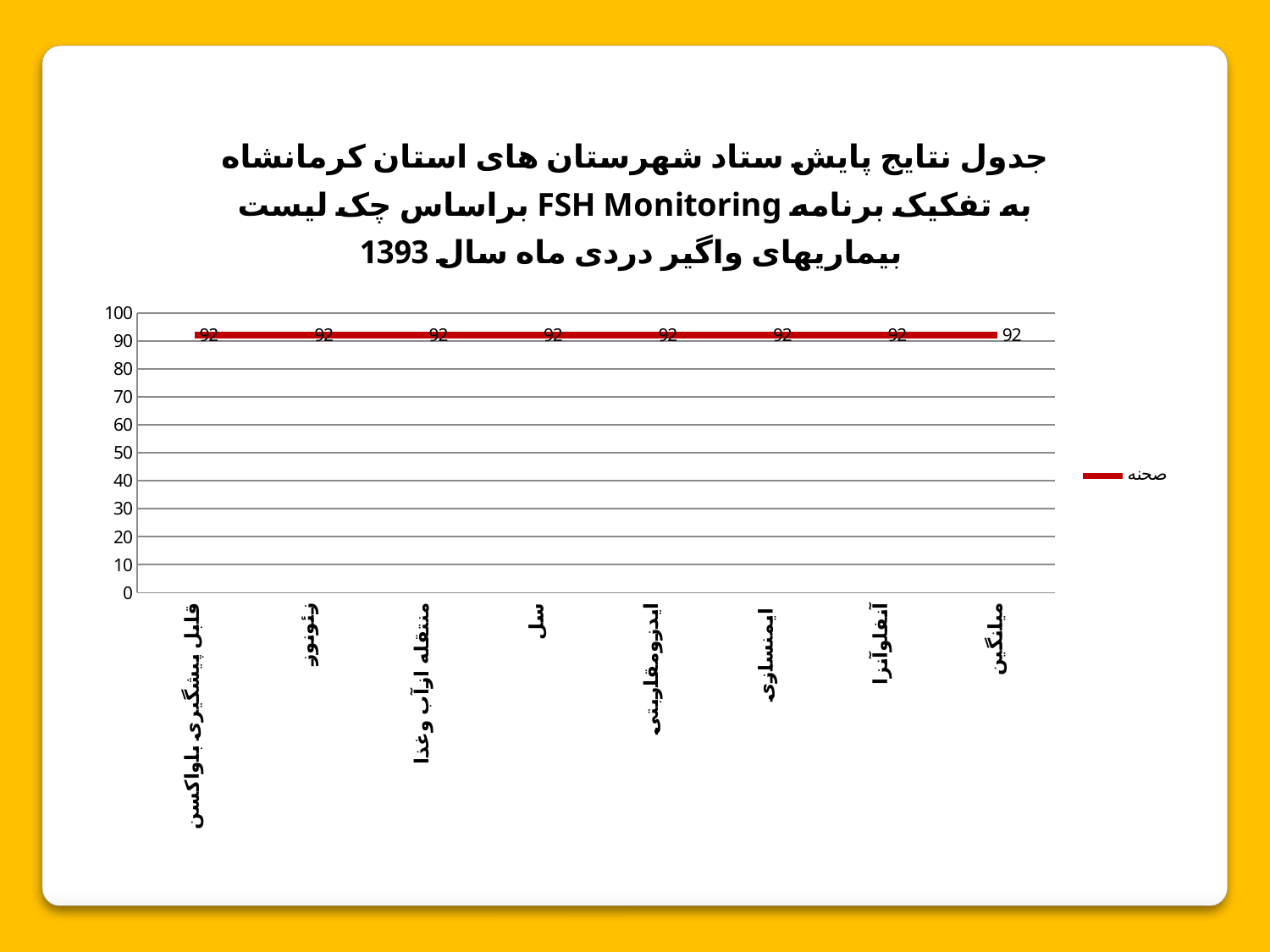
What is the name of the series shown in the legend? صحنه What is the difference between the values for ایمنسازی and سل? 0 What is the value for سل? 92 What colour is the line in the chart? red What is the value for زئونوز? 92 What kind of chart is shown on the slide? line chart How many categories are shown on the x axis? 8 Is the value for ایدز و مقاربتی greater or less than 80? greater How many series does the legend list? 1 What is the value for آنفلوآنزا? 92 What is the value for میانگین? 92 Do the values rise, fall, or stay flat across the categories? stay flat